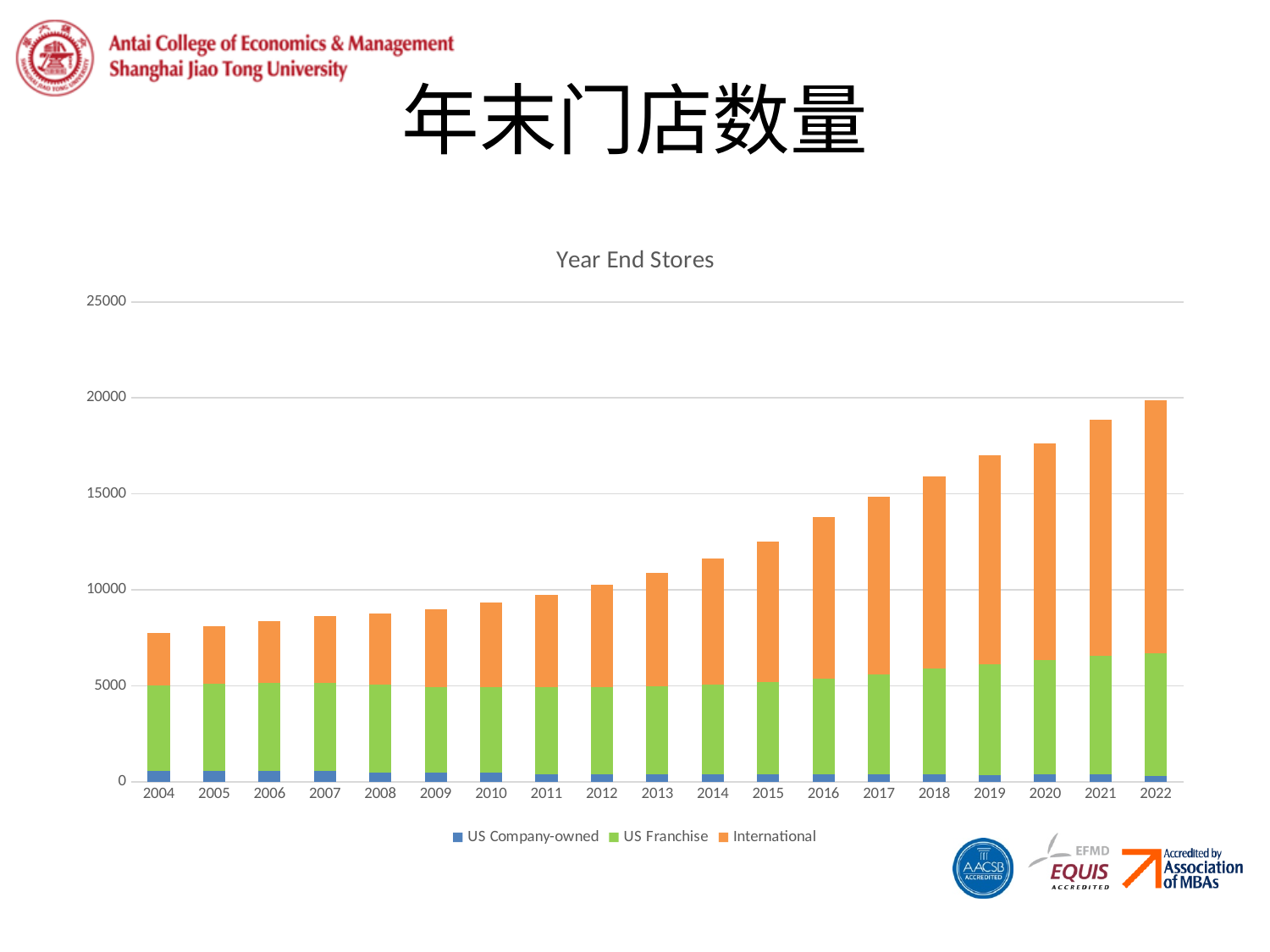
Which year has the highest total number of year-end stores? 2022 Which year has a larger total number of stores, 2010 or 2020? 2020 Do the total year-end store counts rise or fall from 2004 to 2022? Rise What is the title of the chart? Year End Stores How many series does the legend list? 3 Is the total number of stores in 2004 greater or less than 10000? less Which year has the lowest total number of year-end stores? 2004 How many years are shown on the x axis? 19 Is the total number of stores in 2016 greater or less than 10000? greater What kind of chart is shown on the slide? Stacked bar chart Which series is shown in orange in the legend? International